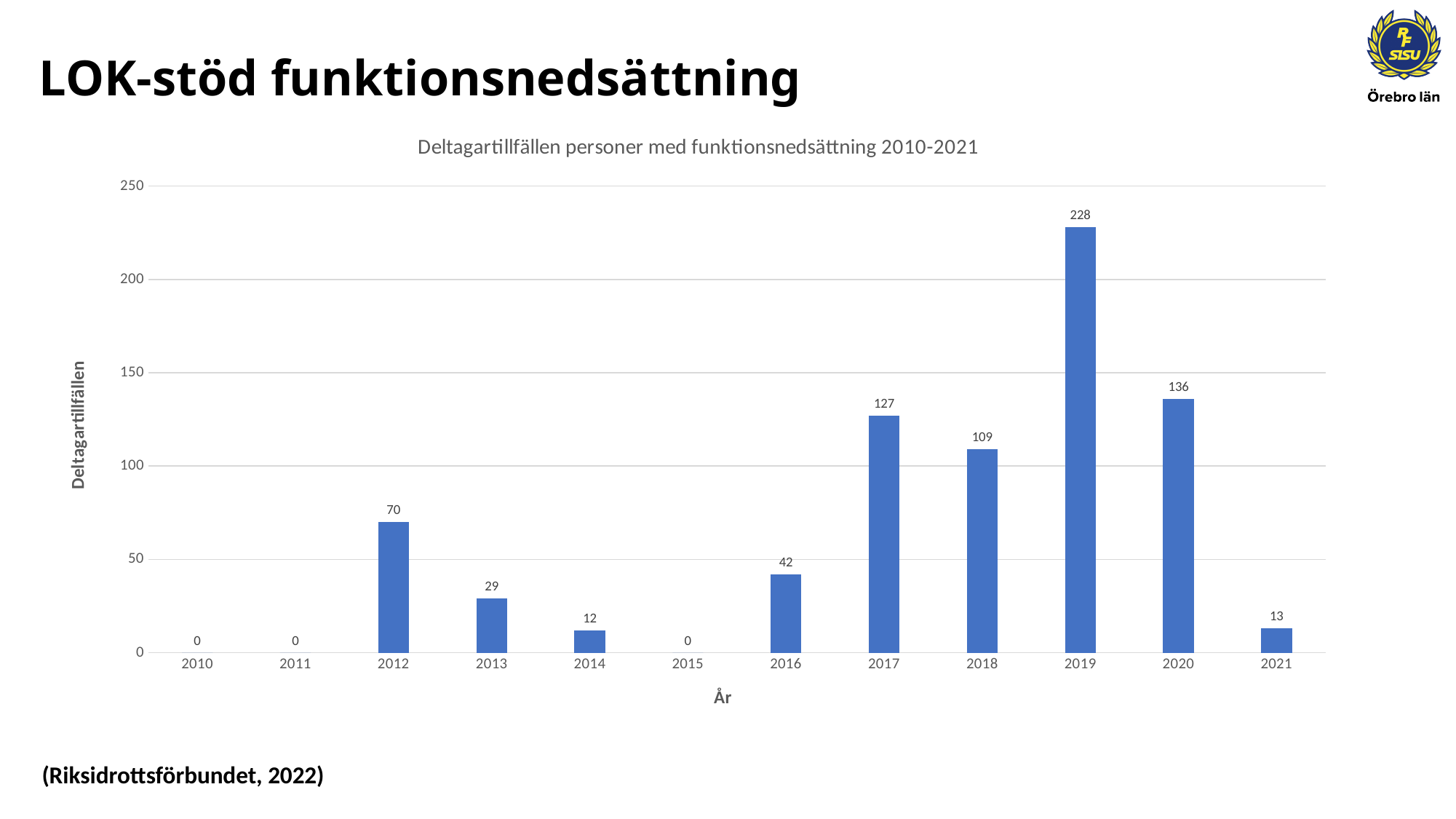
What kind of chart is this? Bar chart Which year has the highest value? 2019 What is the title of the chart? Deltagartillfällen personer med funktionsnedsättning 2010-2021 Do the values rise or fall from 2019 to 2021? Fall What is the difference between the values for 2019 and 2020? 92 Which years have a value of 0? 2010, 2011, 2015 How many years are shown on the x axis? 12 Is the value for 2020 greater or less than 100? greater What is the value for 2012? 70 What is the value for 2019? 228 Which is larger, the value for 2017 or the value for 2018? 2017 What is the value for 2021? 13